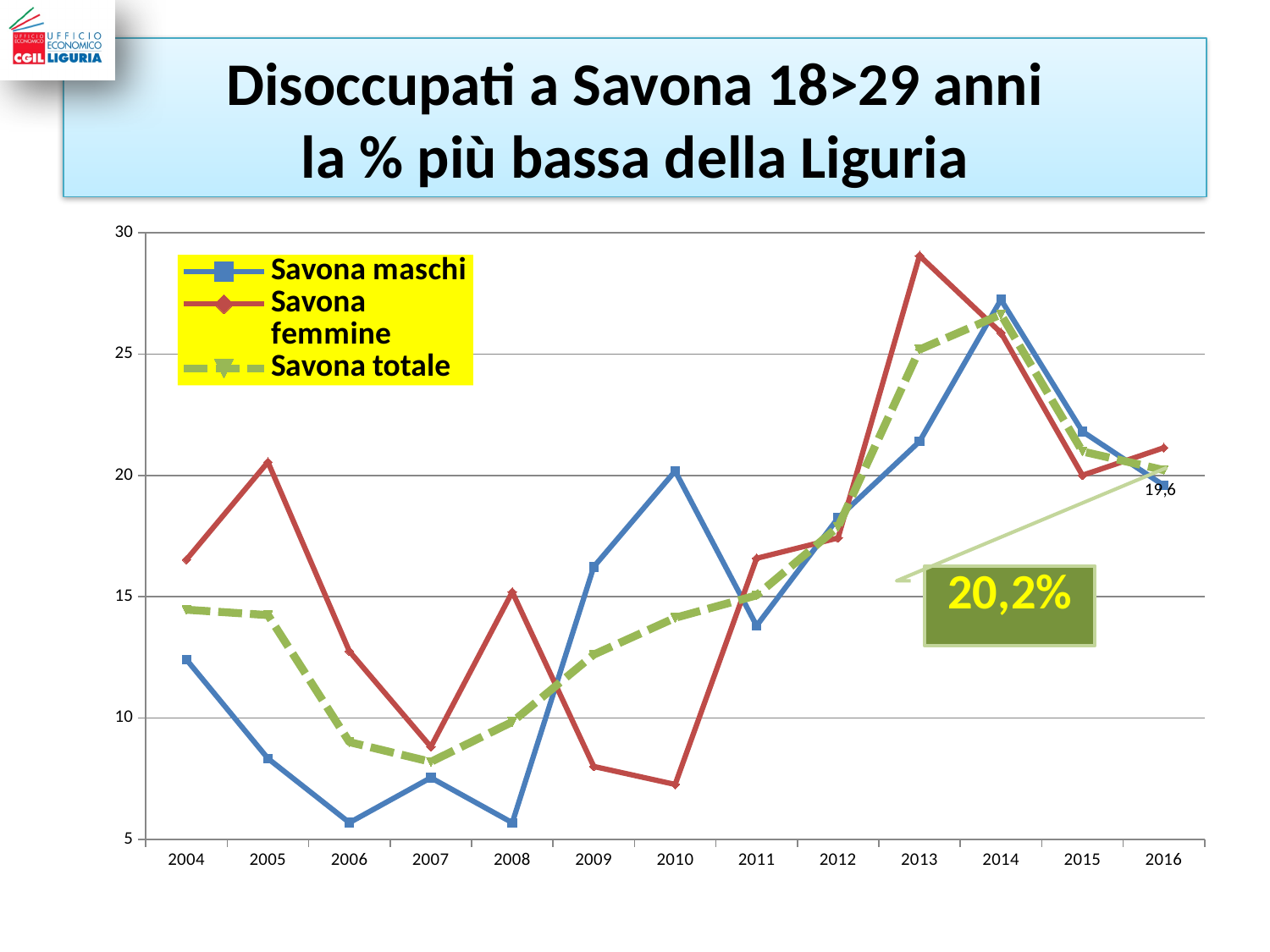
What value does the callout give for Savona totale in 2016? 20,2% What kind of chart is shown on the slide? line chart In 2010, which is higher: Savona maschi or Savona femmine? Savona maschi What is the value for Savona maschi in 2016? 19,6 In which year is Savona totale at its lowest? 2007 How many series does the legend list? 3 In which year does Savona femmine reach its highest value? 2013 Does Savona totale rise or fall from 2011 to 2014? rise In which year does Savona maschi reach its highest value? 2014 How many years are shown on the x axis? 13 Is the value for Savona femmine in 2010 greater or less than 10? less Is the value for Savona femmine in 2013 greater or less than 25? greater